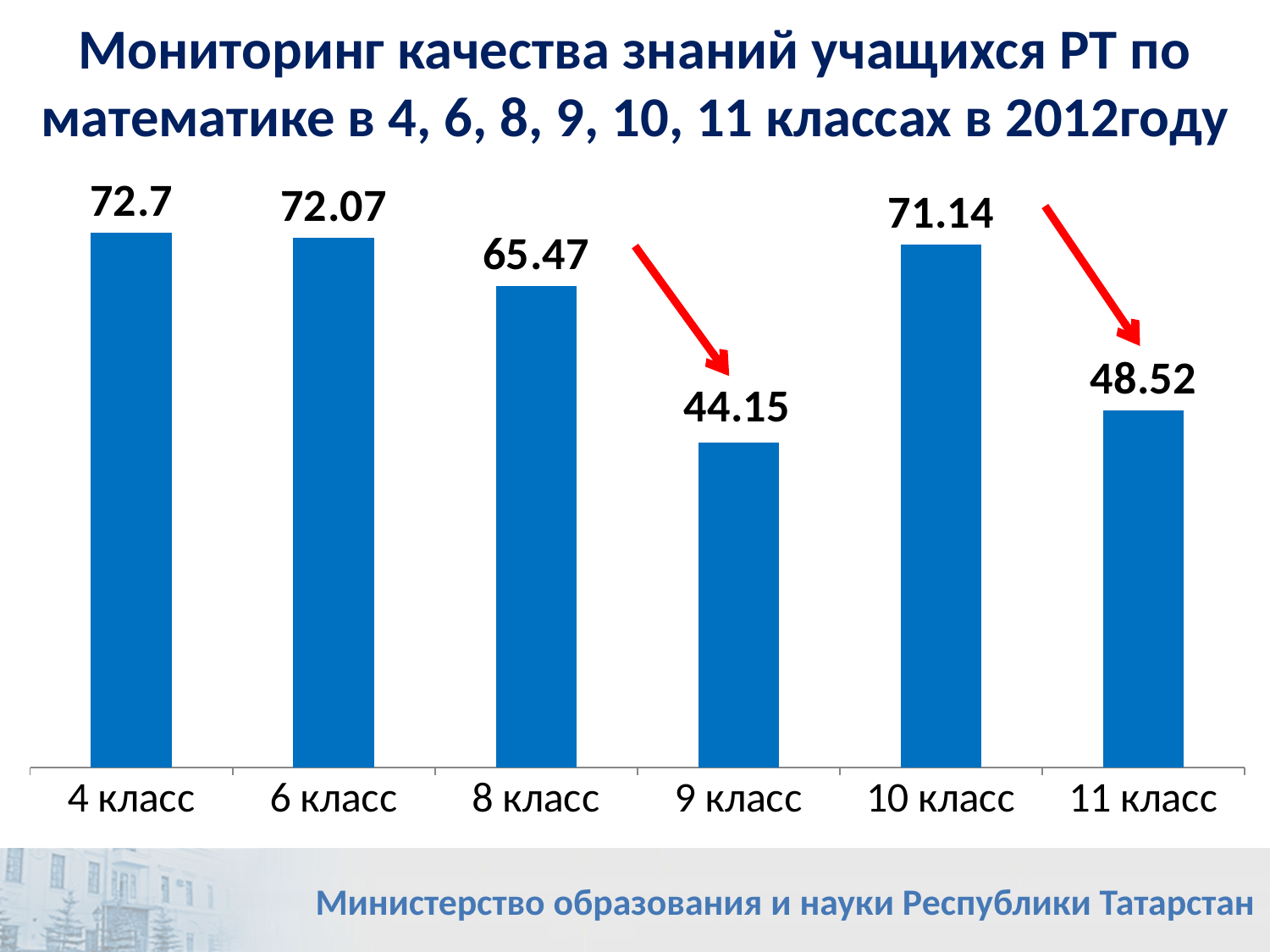
What is the value for 11 класс? 48.52 What is the value for 4 класс? 72.7 Which is larger, the value for 8 класс or the value for 11 класс? 8 класс What is the value for 8 класс? 65.47 What kind of chart is shown on the slide? Bar chart Which class has the lowest value? 9 класс What is the value for 9 класс? 44.15 What is the difference between the values for 10 класс and 11 класс? 22.62 Which class has the highest value? 4 класс What is the difference between the values for 4 класс and 9 класс? 28.55 What colour are the bars in the chart? Blue How many classes are shown in the chart? 6